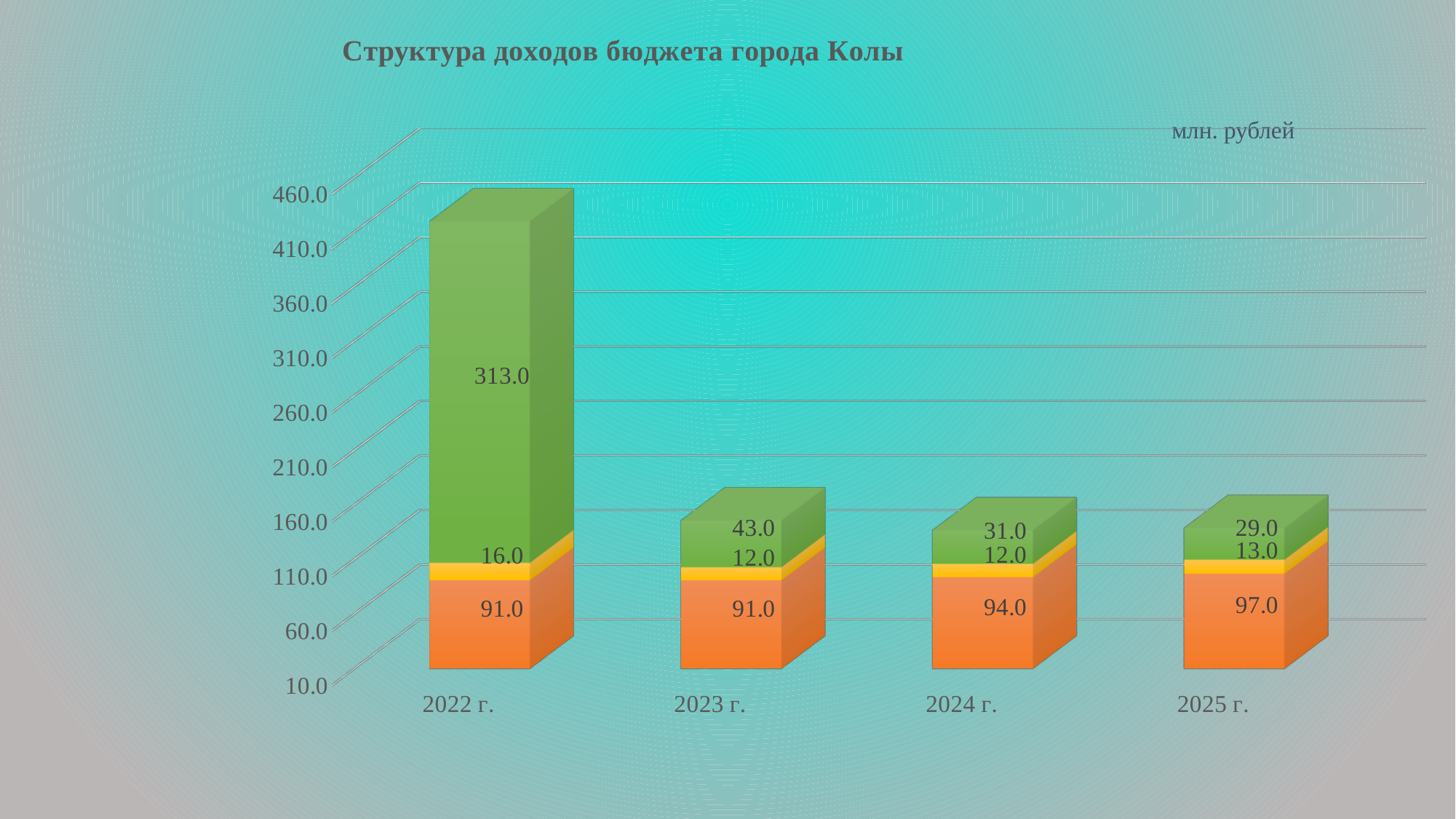
Which is larger: the orange segment for 2024 г. or the orange segment for 2025 г.? 2025 г. What is the value of the green (top) segment for 2022 г.? 313.0 Which year has the highest value for the green (top) segment? 2022 г. What is the value of the orange (bottom) segment for 2025 г.? 97.0 Which year has the lowest value for the green (top) segment? 2025 г. What is the value of the yellow (middle) segment for 2023 г.? 12.0 What is the difference between the green segment values for 2022 г. and 2023 г.? 270.0 What is the total of the stacked bar for 2022 г.? 420.0 What is the title of the chart? Структура доходов бюджета города Колы What is the total of the stacked bar for 2024 г.? 137.0 What type of chart is shown on the slide? stacked bar chart How many years (categories) are shown on the x axis? 4